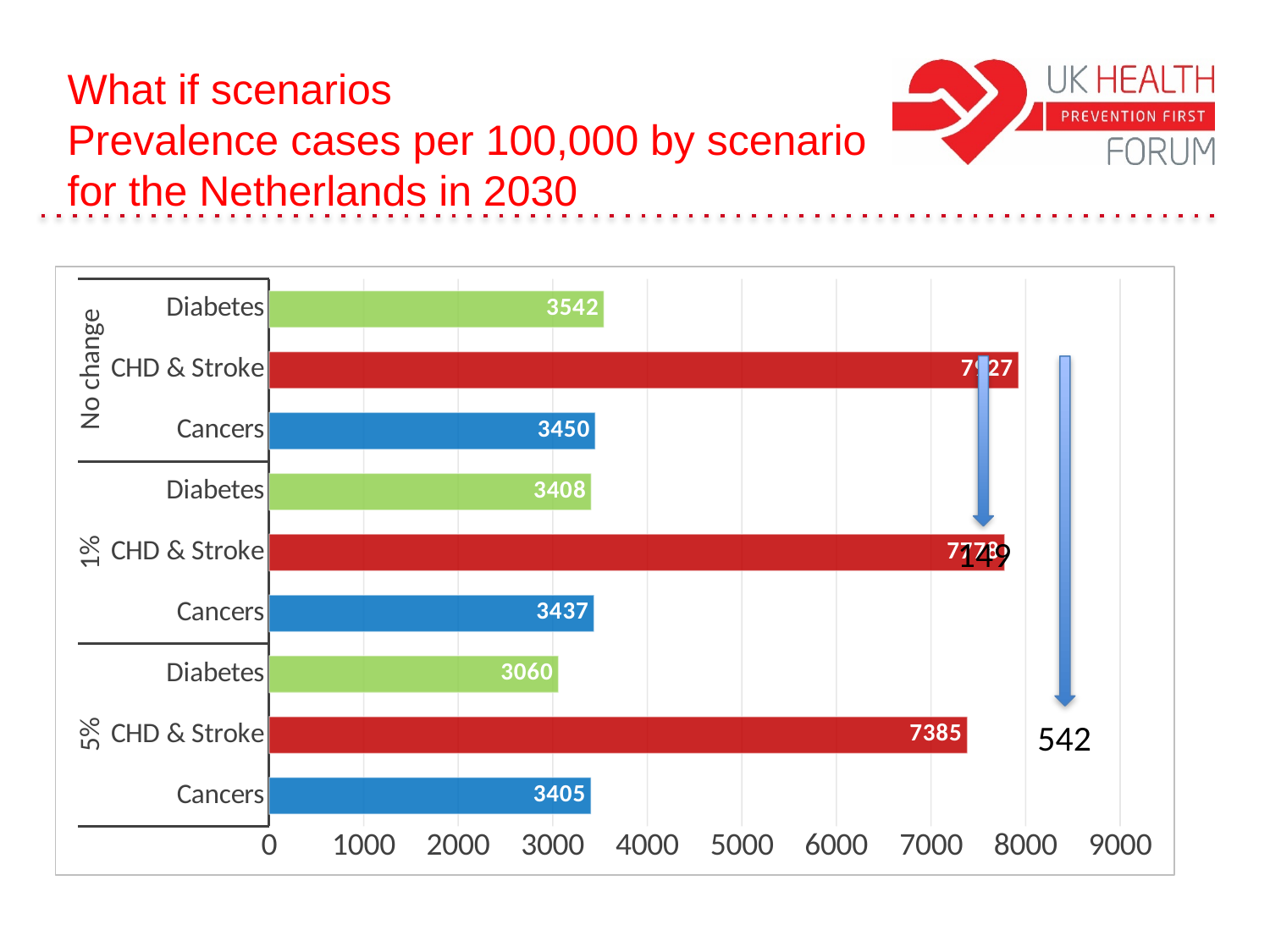
What is the difference between the Diabetes values for the No change and 5% scenarios? 482 What is the difference between the Cancers values for the No change and 5% scenarios? 45 Is the value for CHD & Stroke under the No change scenario greater or less than 7000? greater What is the value for Cancers under the 1% scenario? 3437 How many bars are plotted on the chart? 9 What is the value for Diabetes under the 5% scenario? 3060 What is the value for Diabetes under the No change scenario? 3542 What is the value for CHD & Stroke under the 5% scenario? 7385 What kind of chart is shown on the slide? Bar chart Which bar has the lowest value on the chart? Diabetes under the 5% scenario Under the No change scenario, which is larger: Diabetes or Cancers? Diabetes What number is annotated next to the long blue arrow on the right of the chart? 542